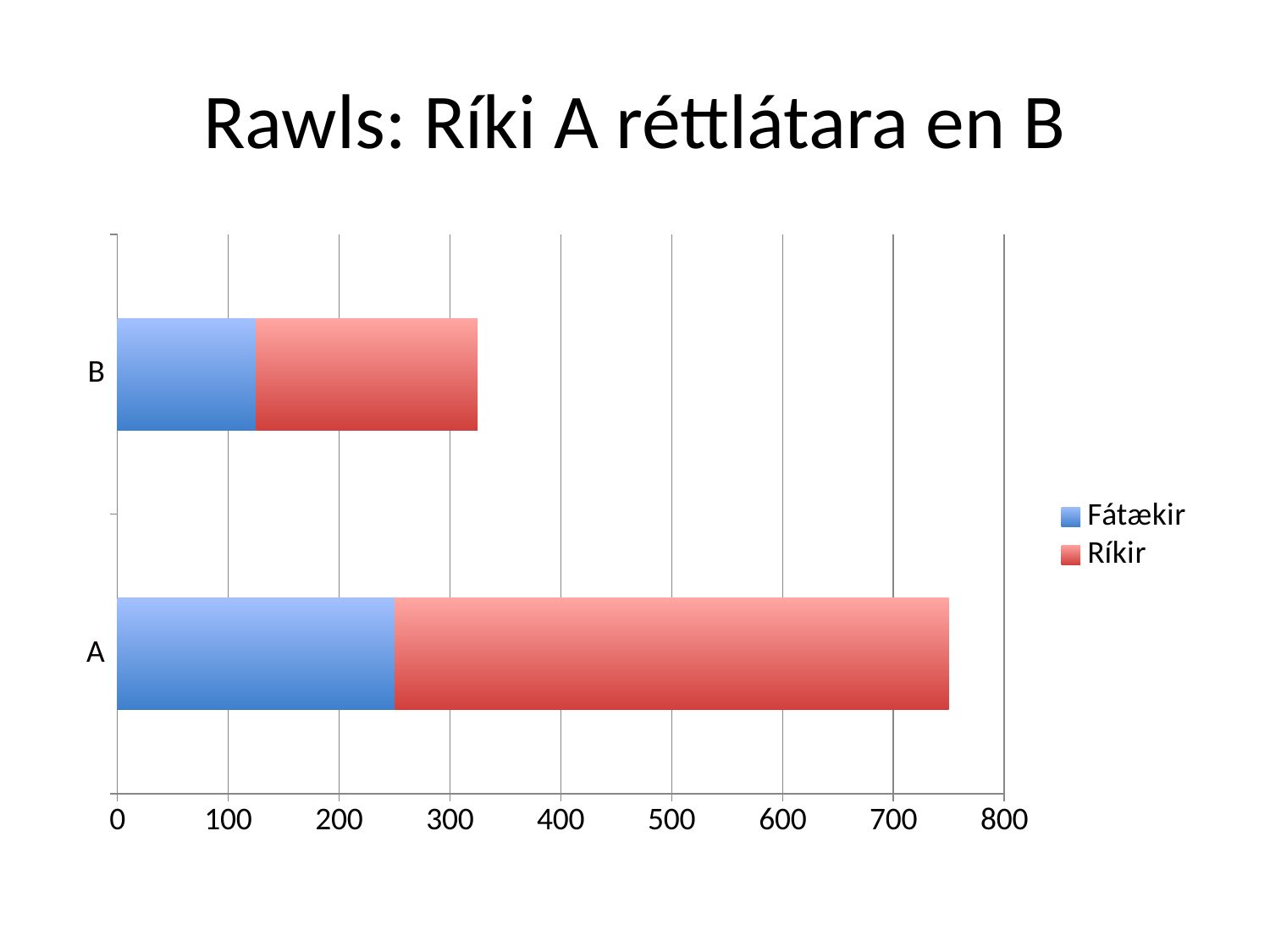
What is the title of the chart? Rawls: Ríki A réttlátara en B Is the Fátækir value for B greater or less than 200? less How many categories are shown on the vertical axis? 2 Is the Fátækir value for A greater or less than 200? greater Which is larger, the Fátækir value for A or the Fátækir value for B? A Is the total bar for A greater or less than 700? greater Which series is shown in red? Ríkir Which category has the longest total bar? A Which category has the shortest total bar? B What kind of chart is shown on the slide? stacked bar chart How many series does the legend list? 2